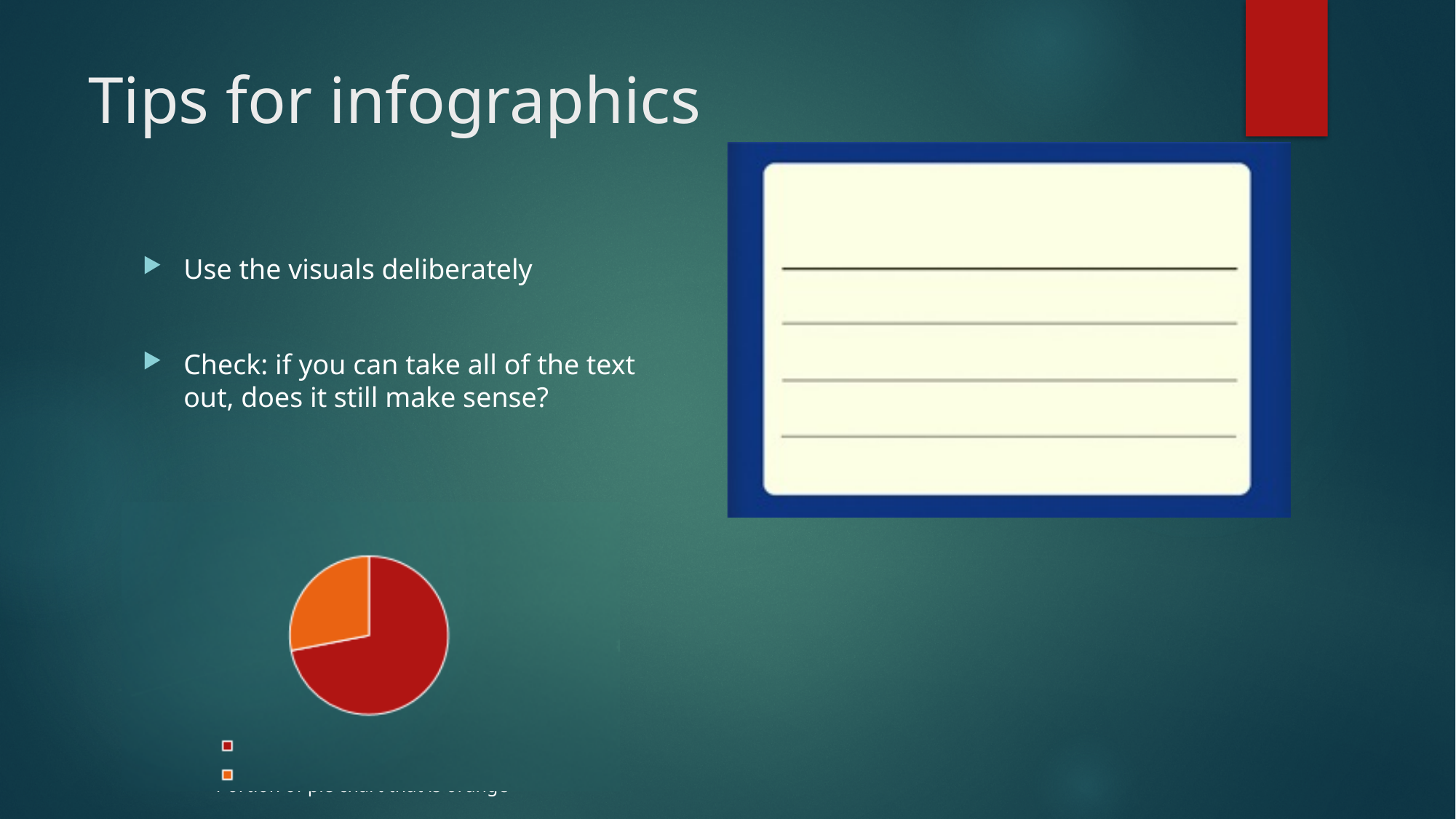
Does the pie chart display any data labels with values on its slices? No How many slices does the pie chart have? 2 Which slice of the pie chart is larger, the red one or the orange one? the red one What kind of chart is shown at the bottom left of the slide? pie chart What two colours are used for the slices of the pie chart? red and orange How many entries does the legend of the pie chart list? 2 Which slice of the pie chart is the smallest? the orange slice Which slice of the pie chart is the largest? the red slice